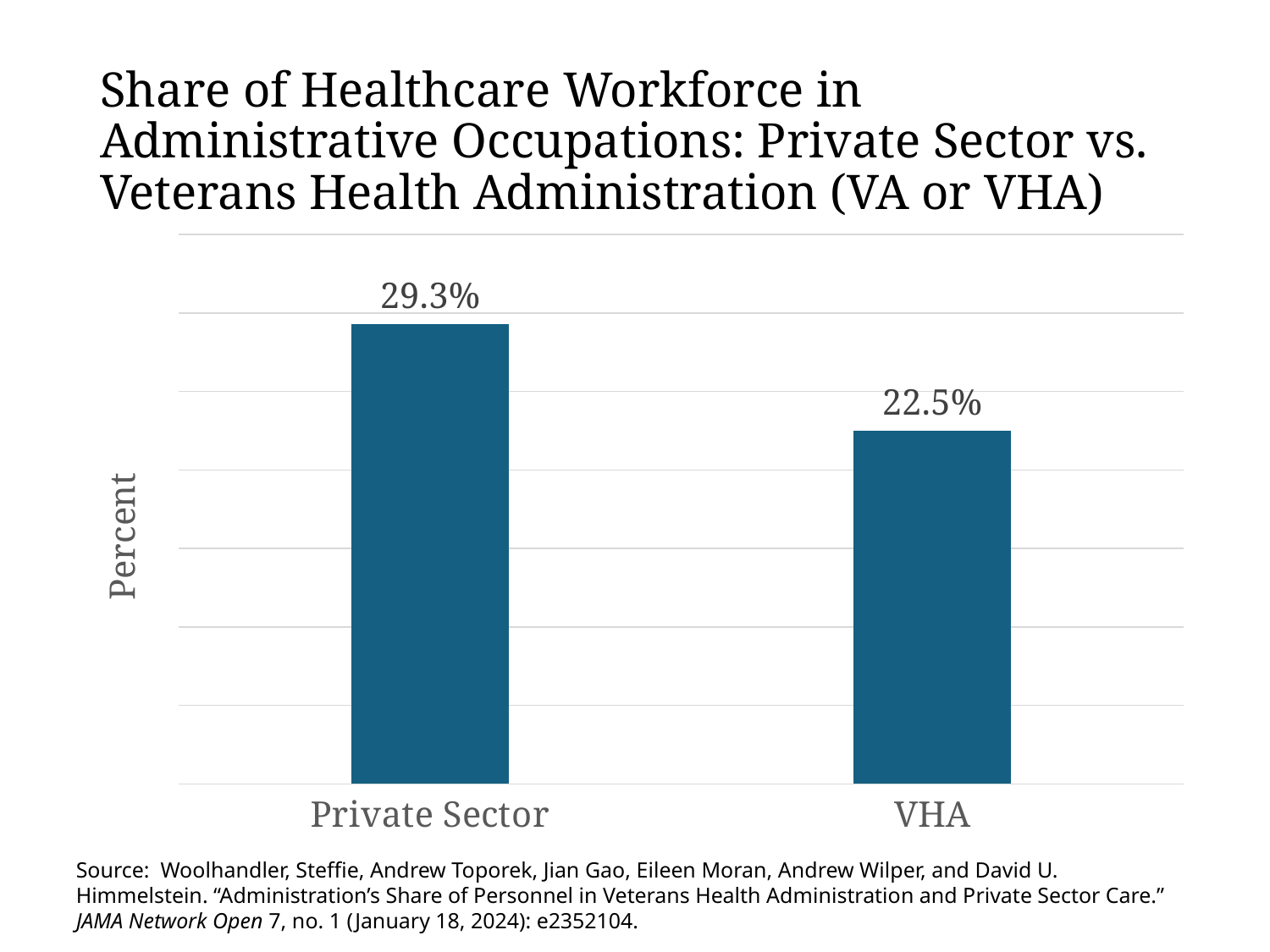
Which is larger, the value for Private Sector or the value for VHA? Private Sector What kind of chart is shown on the slide? Bar chart What is the difference between the Private Sector and VHA values? 6.8% Which category has the highest value? Private Sector Which category has the lowest value? VHA What is the value for Private Sector? 29.3% What is the value for VHA? 22.5% How many categories are shown on the chart? 2 What is the label of the vertical axis? Percent What is the title of the chart? Share of Healthcare Workforce in Administrative Occupations: Private Sector vs. Veterans Health Administration (VA or VHA)